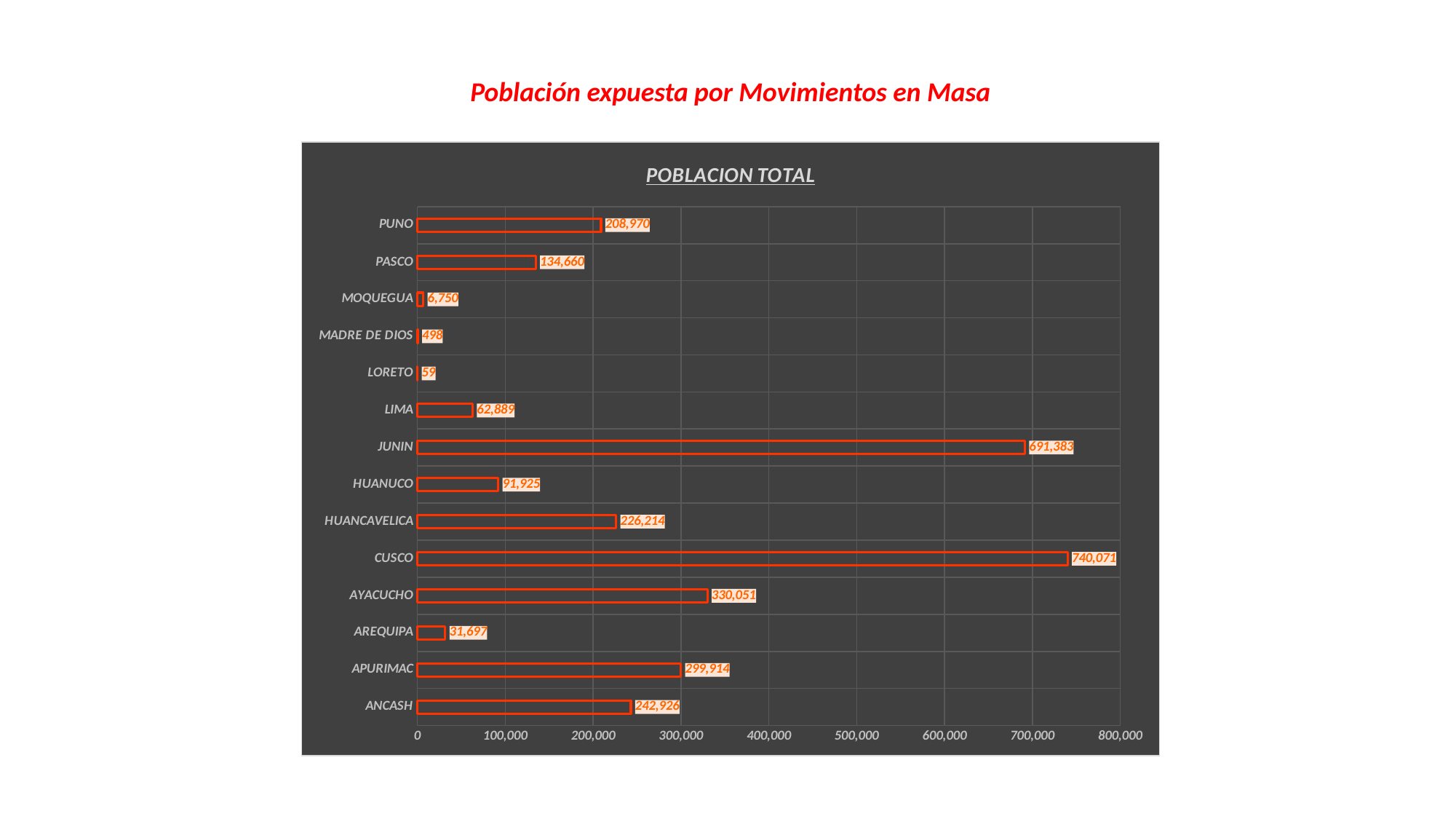
Is the value for HUANCAVELICA greater or less than 200,000? greater What kind of chart is shown? bar chart What is the title of the chart? POBLACION TOTAL What is the difference between the values for CUSCO and JUNIN? 48,688 Which category has the highest value? CUSCO What is the value for LORETO? 59 What is the difference between the values for PUNO and PASCO? 74,310 Which is larger, the value for AYACUCHO or the value for APURIMAC? AYACUCHO What is the value for CUSCO? 740,071 How many categories are shown on the chart? 14 What is the value for JUNIN? 691,383 Which category has the lowest value? LORETO